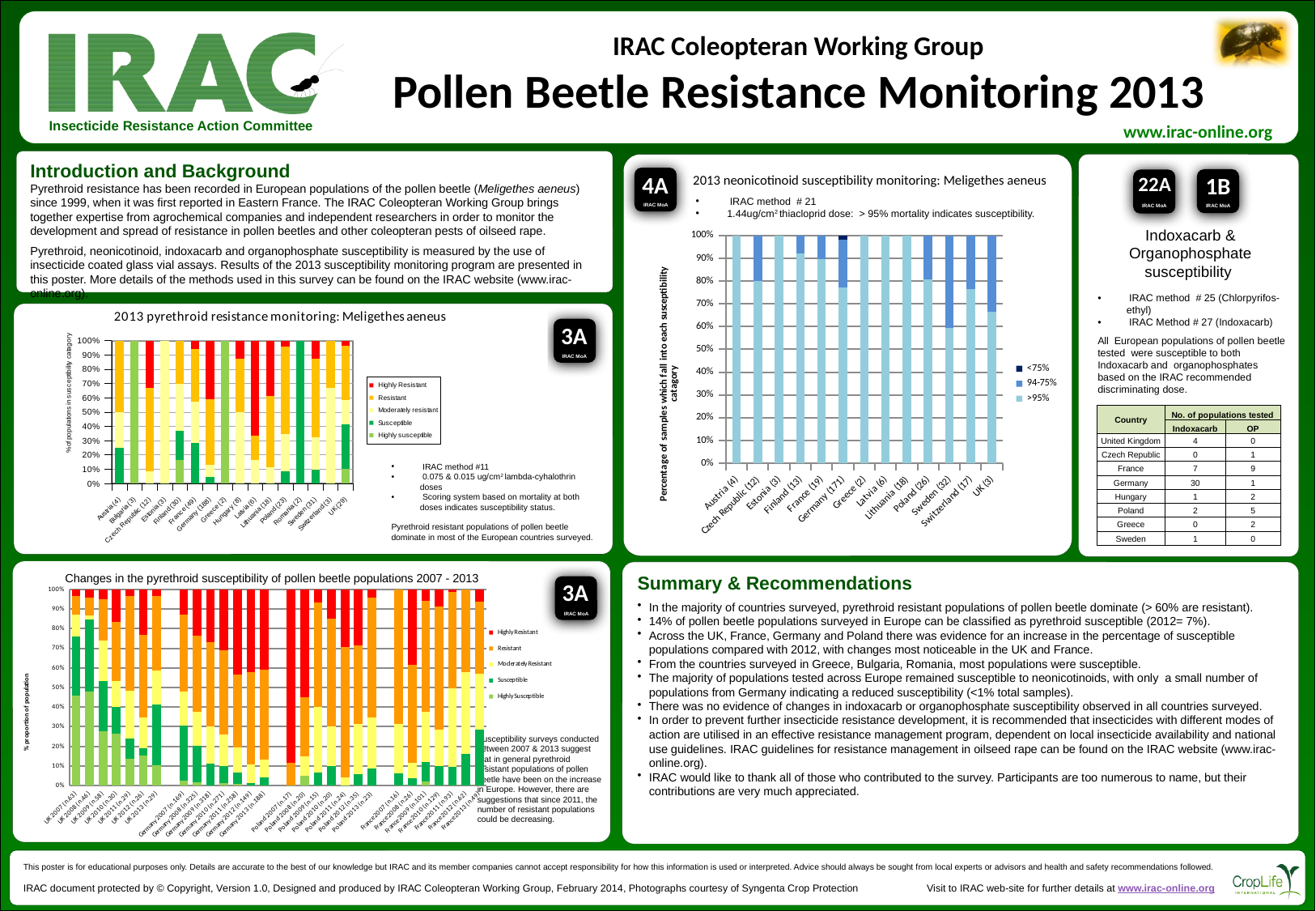
How many series does the legend of the 'Changes in the pyrethroid susceptibility of pollen beetle populations 2007 - 2013' chart list? 5 How many series does the legend of the '2013 neonicotinoid susceptibility monitoring' chart list? 3 In the '2013 neonicotinoid susceptibility monitoring' chart, what is the highest value shown on the y axis? 100% In the '2013 neonicotinoid susceptibility monitoring' chart, what is the '>95%' value for Austria (4)? 100% How many series does the legend of the '2013 pyrethroid resistance monitoring: Meligethes aeneus' chart list? 5 In the '2013 neonicotinoid susceptibility monitoring' chart, is the '>95%' value for Germany (171) greater or less than 50%? greater In the '2013 neonicotinoid susceptibility monitoring' chart, which country is the only one with a '<75%' segment? Germany (171) In the '2013 neonicotinoid susceptibility monitoring' chart, how many countries are shown on the x axis? 13 What kind of chart is the '2013 pyrethroid resistance monitoring: Meligethes aeneus' chart? Stacked bar chart What kind of chart is the '2013 neonicotinoid susceptibility monitoring: Meligethes aeneus' chart? Stacked bar chart In the '2013 pyrethroid resistance monitoring' chart, is the 'Highly Resistant' value for Austria (4) greater or less than 40%? less In the '2013 pyrethroid resistance monitoring: Meligethes aeneus' chart, how many countries are shown on the x axis? 16